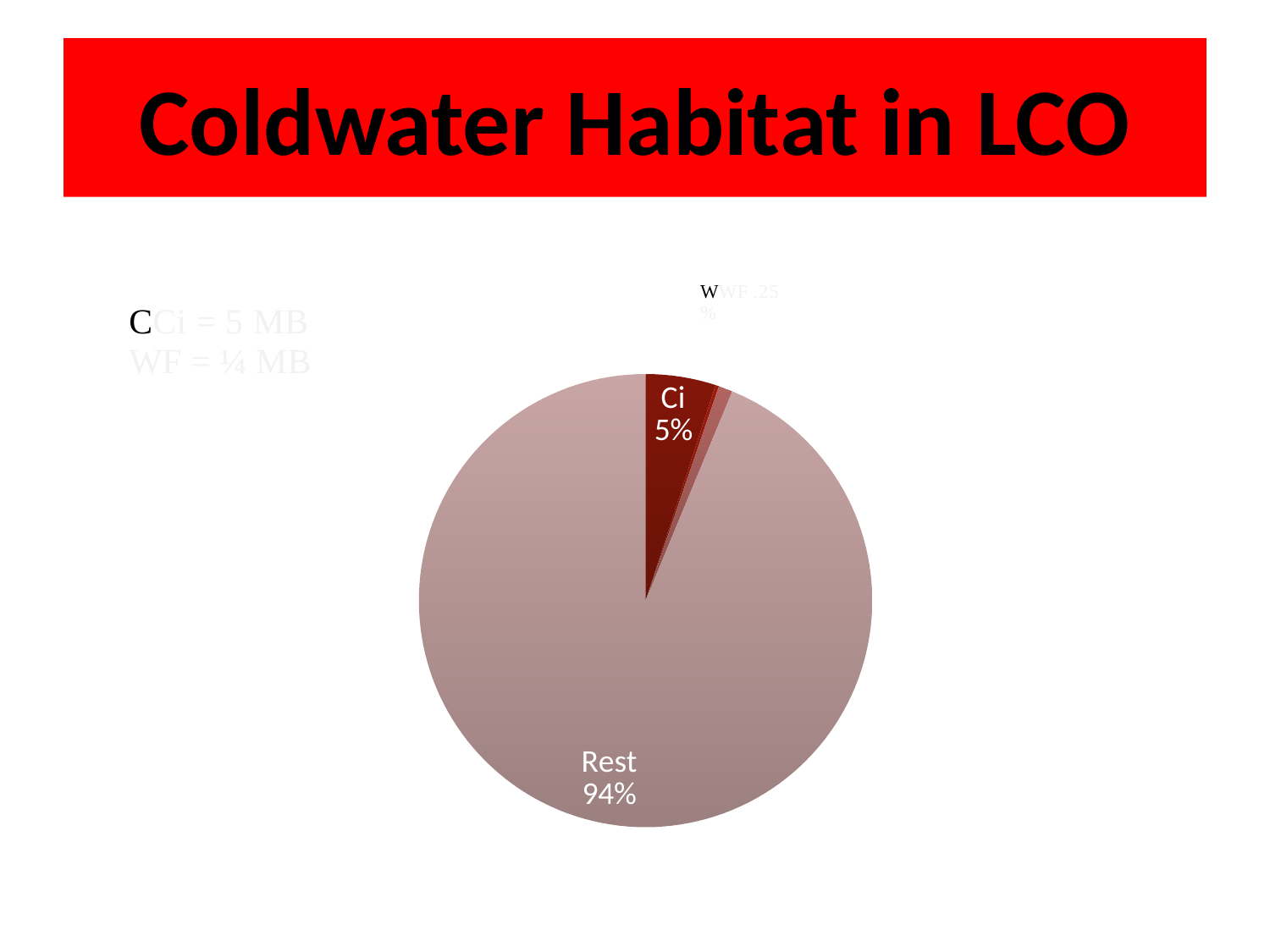
Which is larger, the Ci slice or the Rest slice? Rest What colour is the Ci slice of the pie chart? dark red What is the title of the slide containing the pie chart? Coldwater Habitat in LCO What is the difference in percentage points between the Rest slice and the Ci slice? 89 Which slice of the pie chart is the largest? Rest What share of the pie does the Ci slice represent? 5% What type of chart is shown on the slide? pie chart What share of the pie does the Rest slice represent? 94% Is the share of the Rest slice greater or less than 50%? greater